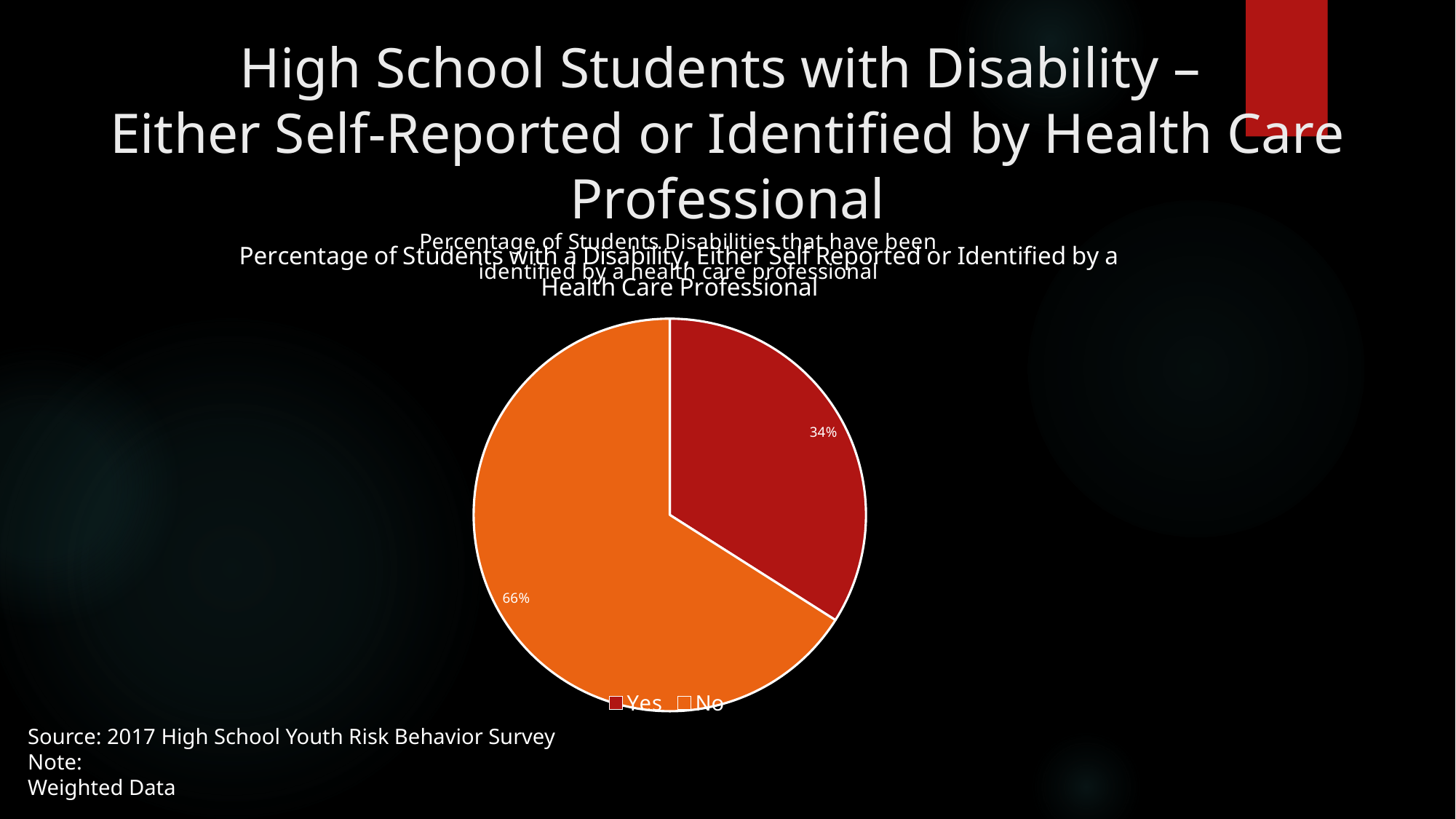
Which is larger, the "Yes" slice or the "No" slice? No Which slice of the pie is the smallest? Yes What source is cited for the data on the slide? 2017 High School Youth Risk Behavior Survey What kind of chart is shown on the slide? pie chart What percentage of the pie is labelled for the "Yes" slice? 34% What share of the pie does the "Yes" slice represent? 34% How many slices does the pie chart have? 2 What is the difference in percentage points between the "No" slice and the "Yes" slice? 32 Which slice of the pie is the largest? No How many entries does the legend list? 2 What percentage of the pie is labelled for the "No" slice? 66% What colour is the "No" slice of the pie? orange